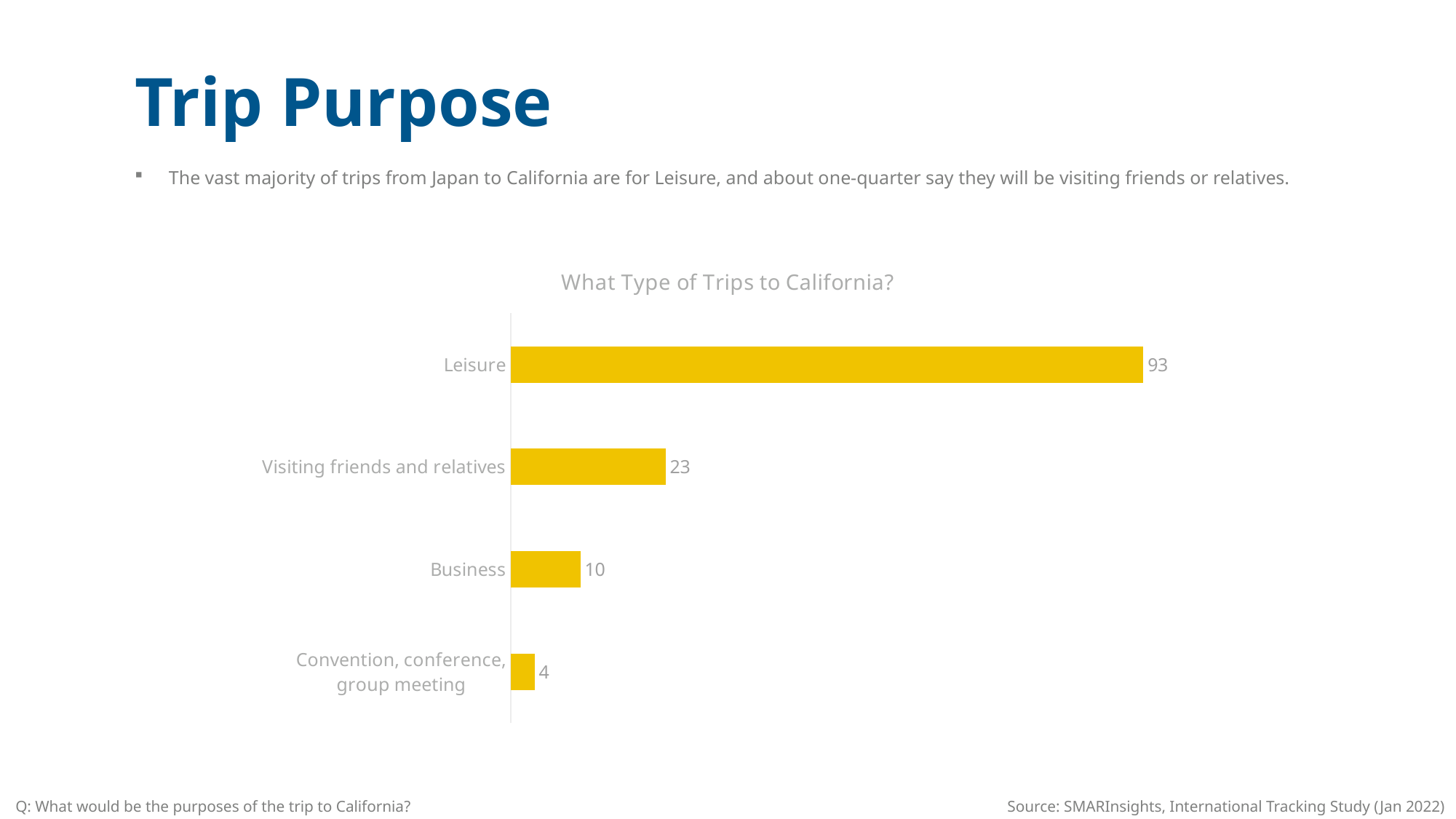
What is the value for Business? 10 Which is larger, the value for Visiting friends and relatives or the value for Business? Visiting friends and relatives What is the value for Leisure? 93 How many categories are shown in the chart? 4 Which category has the highest value? Leisure What is the title of the chart? What Type of Trips to California? What kind of chart is shown on the slide? Bar chart Which category has the lowest value? Convention, conference, group meeting What is the difference between the values for Business and Convention, conference, group meeting? 6 What is the value for Convention, conference, group meeting? 4 What is the value for Visiting friends and relatives? 23 What is the difference between the values for Leisure and Visiting friends and relatives? 70